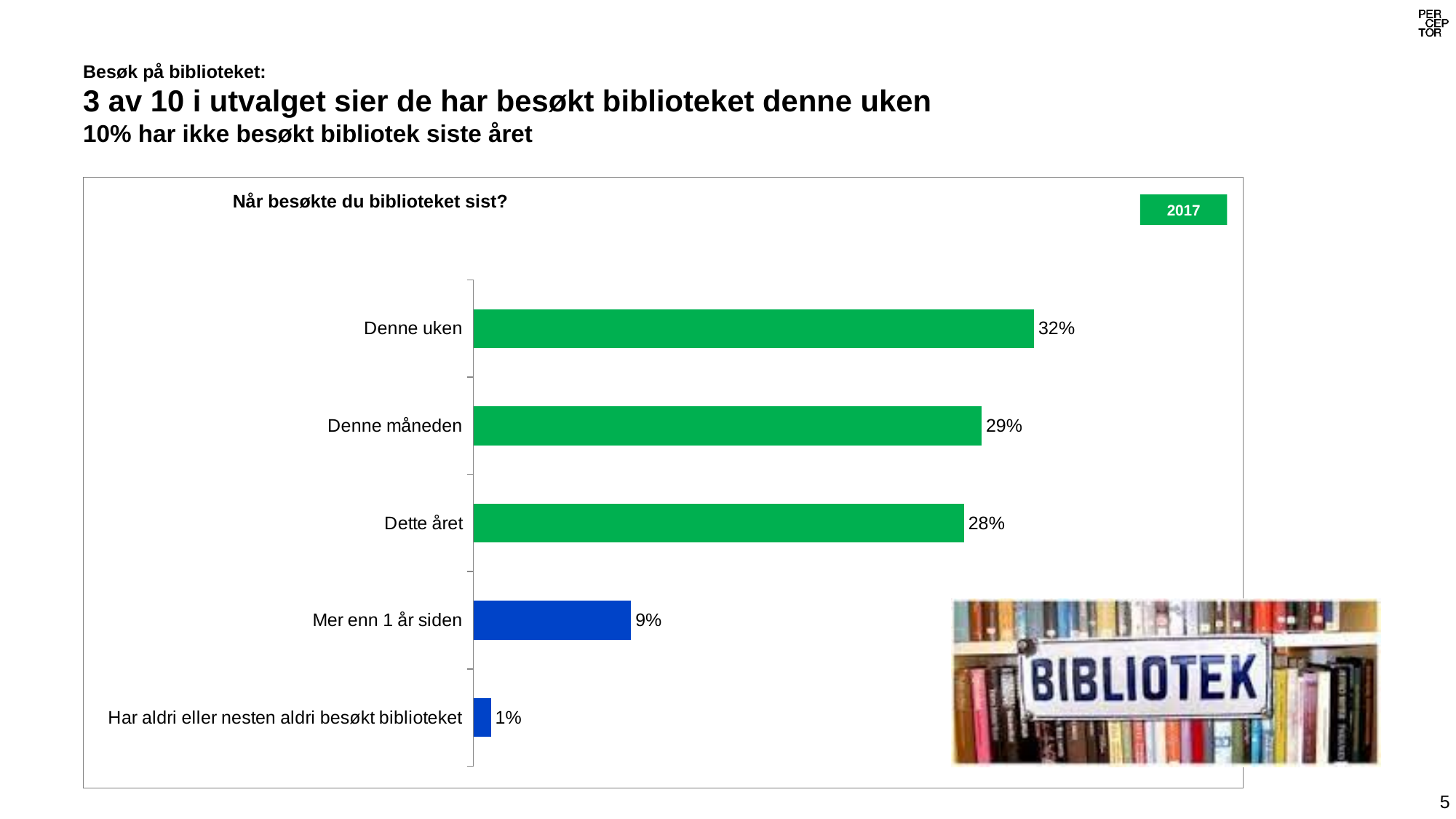
How many categories are shown in the chart? 5 What is the difference between the values for "Denne uken" and "Dette året"? 4% What is the value for "Denne uken"? 32% What is the value for "Mer enn 1 år siden"? 9% Which category has the highest value? Denne uken What kind of chart is shown on the slide? Bar chart Which category has the lowest value? Har aldri eller nesten aldri besøkt biblioteket How many series does the legend list? 1 Which is larger, the value for "Denne måneden" or the value for "Mer enn 1 år siden"? Denne måneden What is the difference between the values for "Mer enn 1 år siden" and "Har aldri eller nesten aldri besøkt biblioteket"? 8% What year does the legend show? 2017 What is the value for "Har aldri eller nesten aldri besøkt biblioteket"? 1%